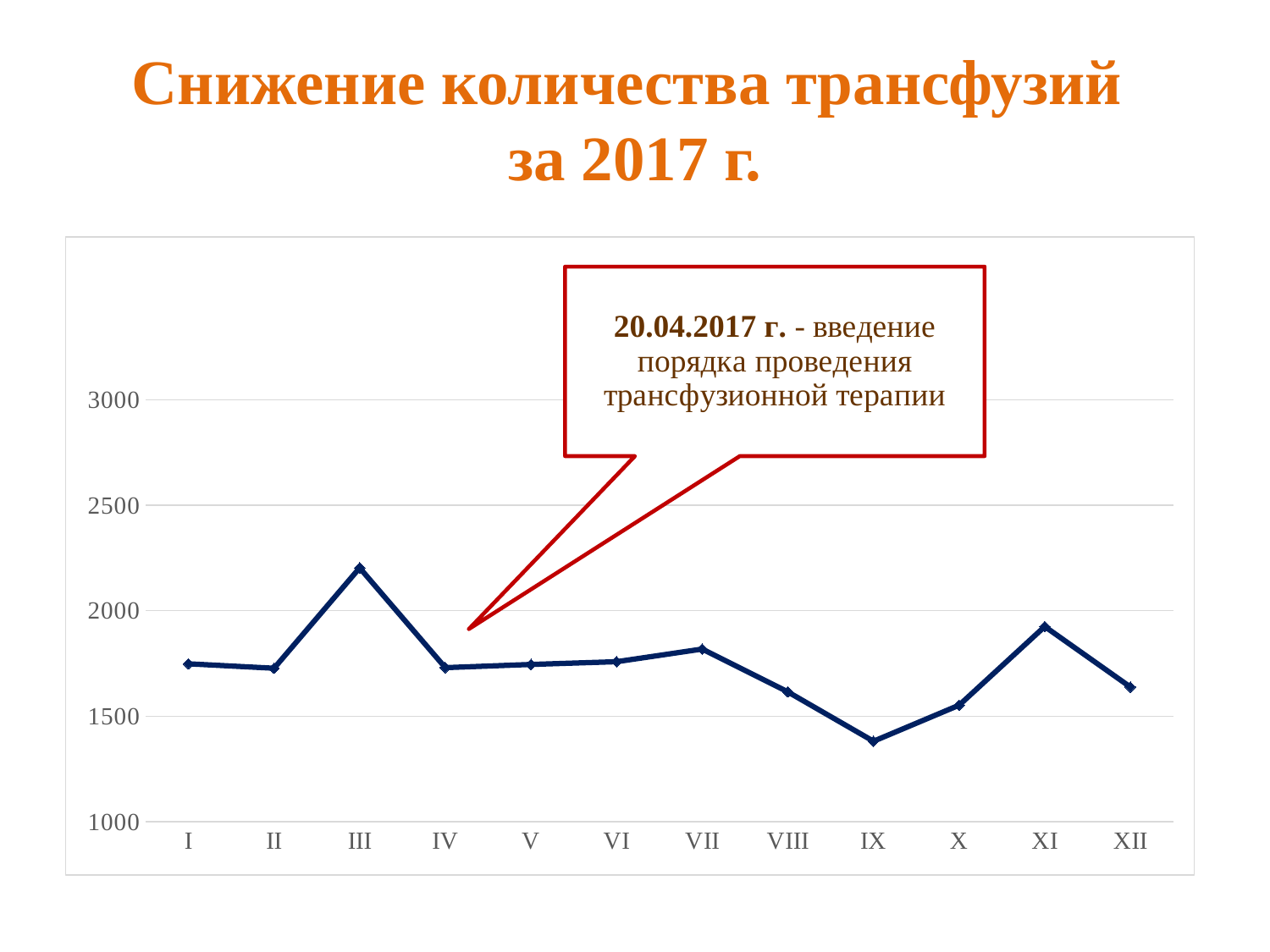
Which is larger, the value for III or the value for IV? III Which month has the highest value on the chart? III Is the value for VIII greater or less than 1500? greater What date is given in the callout box on the chart? 20.04.2017 г. Does the line rise or fall from month III to month IV? fall How many points (months) are plotted along the x axis? 12 Which month has the lowest value on the chart? IX Is the value for IX greater or less than 1500? less Is the value for III greater or less than 2000? greater What kind of chart is shown on the slide? line chart Which is larger, the value for IX or the value for XI? XI